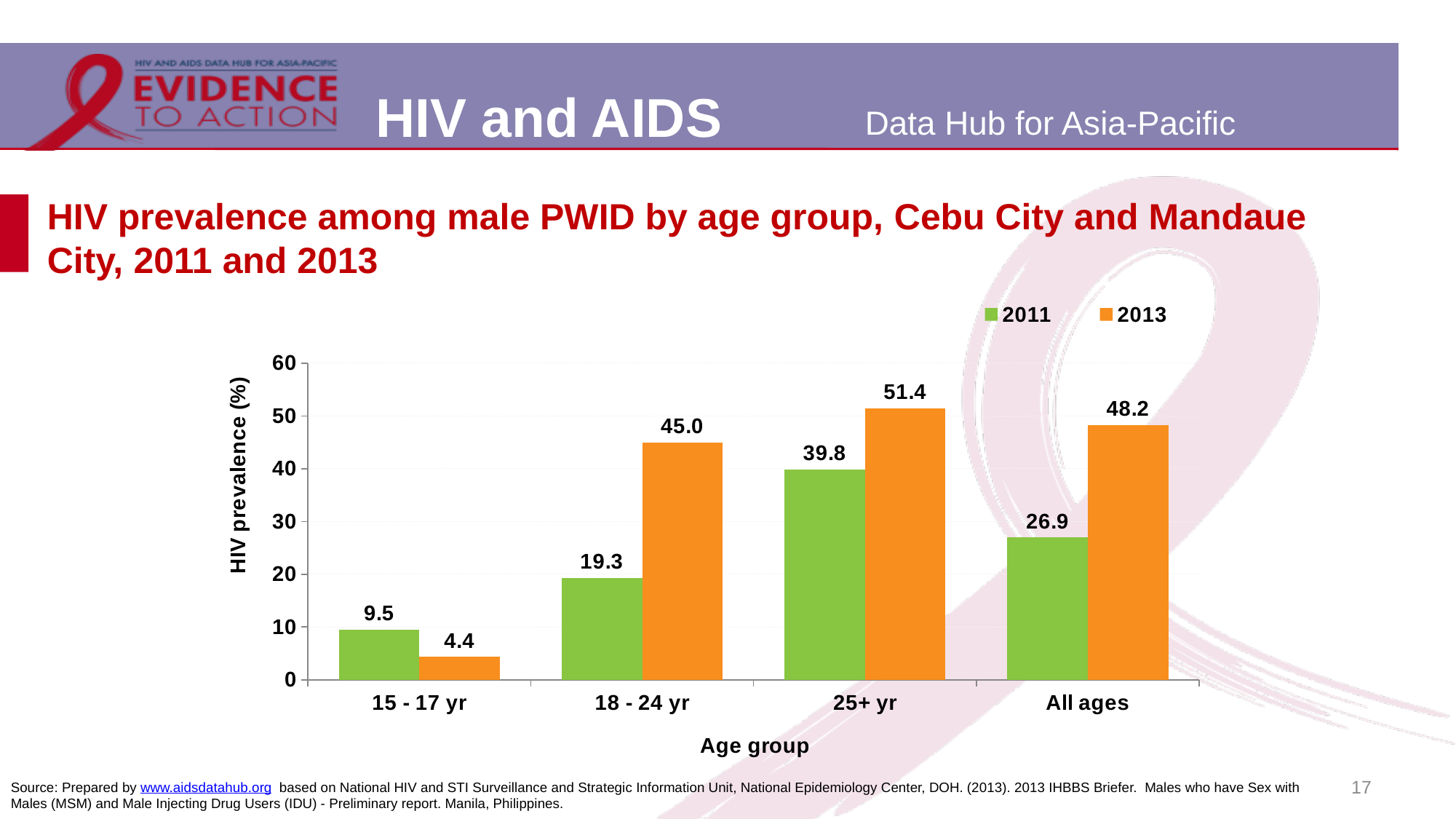
What kind of chart is shown on the slide? bar chart What is the HIV prevalence for the 18 - 24 yr age group in 2013? 45.0 What is the HIV prevalence for the 15 - 17 yr age group in 2011? 9.5 Is the 2011 HIV prevalence for All ages greater or less than 30? less What is the label of the y axis? HIV prevalence (%) What is the difference between the 2013 and 2011 HIV prevalence for the 25+ yr age group? 11.6 How many age groups are shown on the x axis? 4 Which age group has the lowest HIV prevalence in 2011? 15 - 17 yr Which age group has the highest HIV prevalence in 2013? 25+ yr What is the HIV prevalence for All ages in 2013? 48.2 How many series does the legend list? 2 Which is larger for the 15 - 17 yr age group, the 2011 value or the 2013 value? 2011